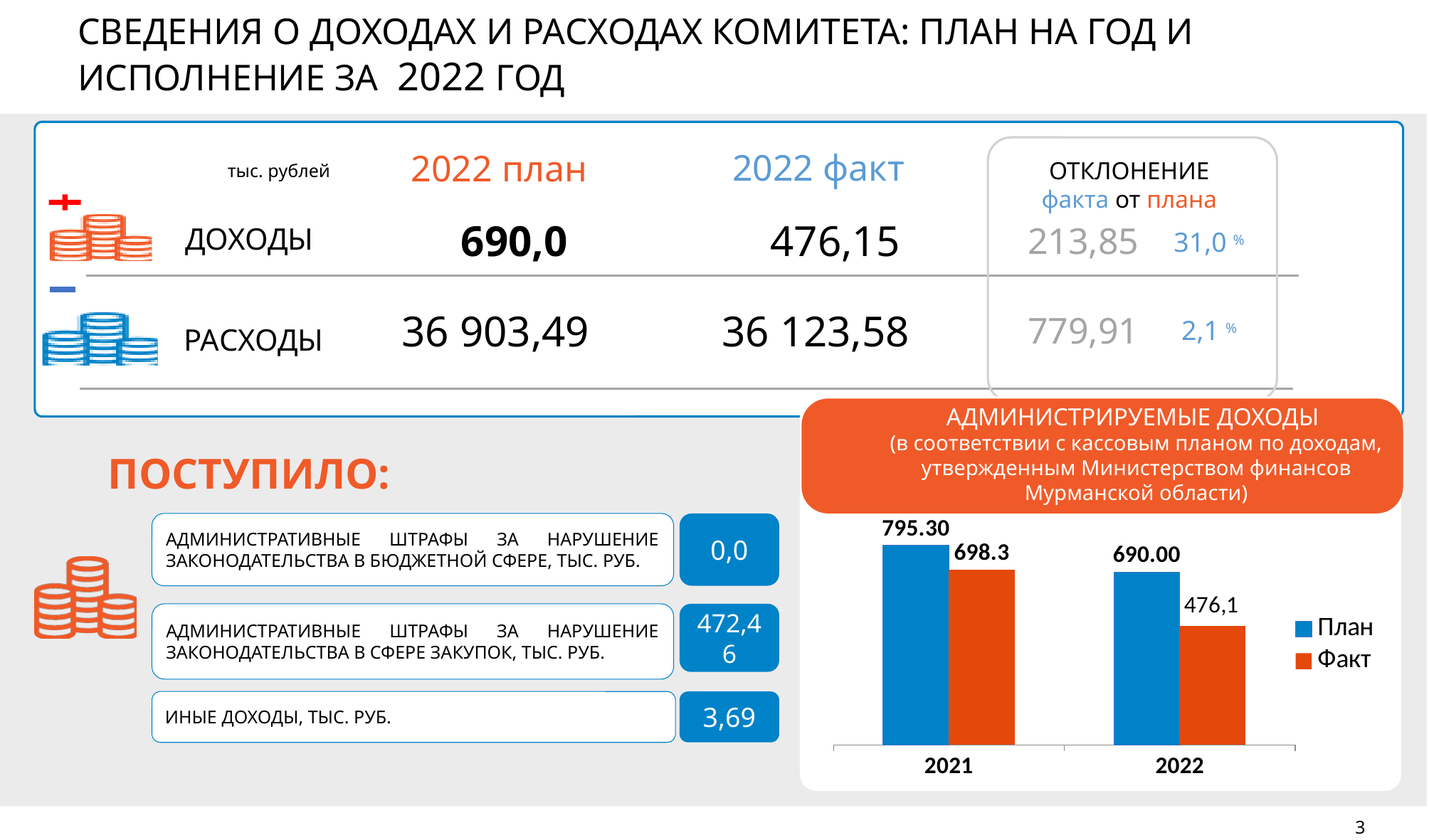
In the bar chart 'АДМИНИСТРИРУЕМЫЕ ДОХОДЫ', what is the value of Факт for 2022? 476,1 In the bar chart 'АДМИНИСТРИРУЕМЫЕ ДОХОДЫ', what is the value of План for 2022? 690.00 In the bar chart 'АДМИНИСТРИРУЕМЫЕ ДОХОДЫ', which bar is the lowest of all four? Факт for 2022 In the bar chart 'АДМИНИСТРИРУЕМЫЕ ДОХОДЫ', what is the value of План for 2021? 795.30 In the bar chart 'АДМИНИСТРИРУЕМЫЕ ДОХОДЫ', which year has the higher Факт value? 2021 In the bar chart 'АДМИНИСТРИРУЕМЫЕ ДОХОДЫ', how many years are shown on the x axis? 2 In the bar chart 'АДМИНИСТРИРУЕМЫЕ ДОХОДЫ', which colour represents the Факт series? orange What type of chart is 'АДМИНИСТРИРУЕМЫЕ ДОХОДЫ'? bar chart In the bar chart 'АДМИНИСТРИРУЕМЫЕ ДОХОДЫ', what is the value of Факт for 2021? 698.3 In the bar chart 'АДМИНИСТРИРУЕМЫЕ ДОХОДЫ', is the План value for 2021 larger or smaller than the План value for 2022? larger In the bar chart 'АДМИНИСТРИРУЕМЫЕ ДОХОДЫ', how many series does the legend list? 2 In the bar chart 'АДМИНИСТРИРУЕМЫЕ ДОХОДЫ', what is the difference between the План values for 2021 and 2022? 105.30